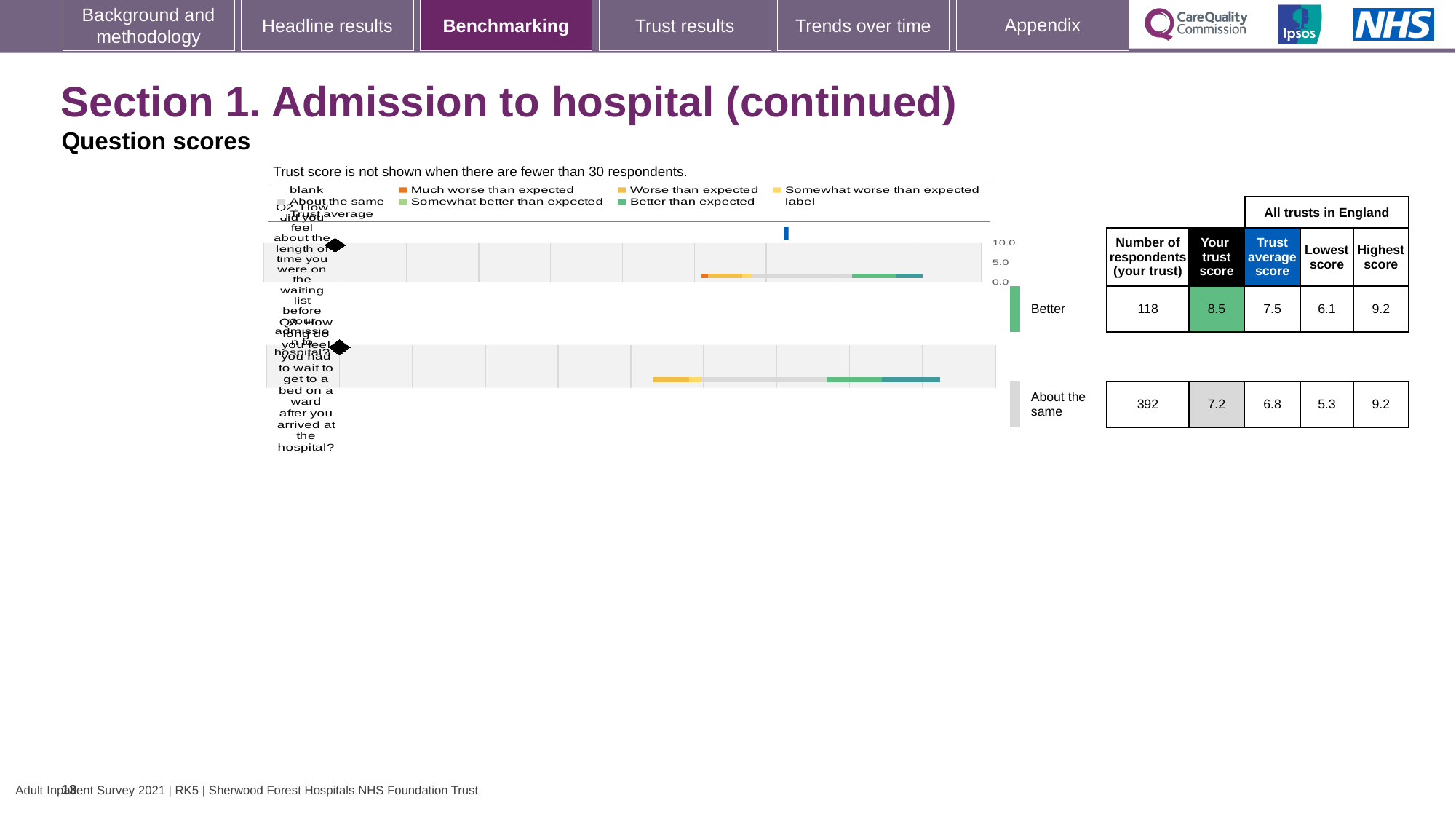
By how much does the trust score for Q2 exceed the all-trusts average score for Q2? 1.0 What kind of chart is used to show the question scores on this slide? bar chart Is the trust score for Q3 greater or less than 5.0 on the chart axis? greater How many questions are plotted in the question scores chart? 2 What benchmark category is shown next to the Q2 bar? Better What is the trust score for Q3 (how long did you feel you had to wait to get to a bed on a ward)? 7.2 What is the lowest score across all trusts in England for Q3? 5.3 Which question has the higher trust score, Q2 or Q3? Q2 What is the trust average score across all trusts in England for Q3? 6.8 How many respondents answered Q2 at this trust? 118 What is the difference between the trust score and the trust average score for Q3? 0.4 What is the trust score for Q2 (how did you feel about the length of time on the waiting list before admission)? 8.5